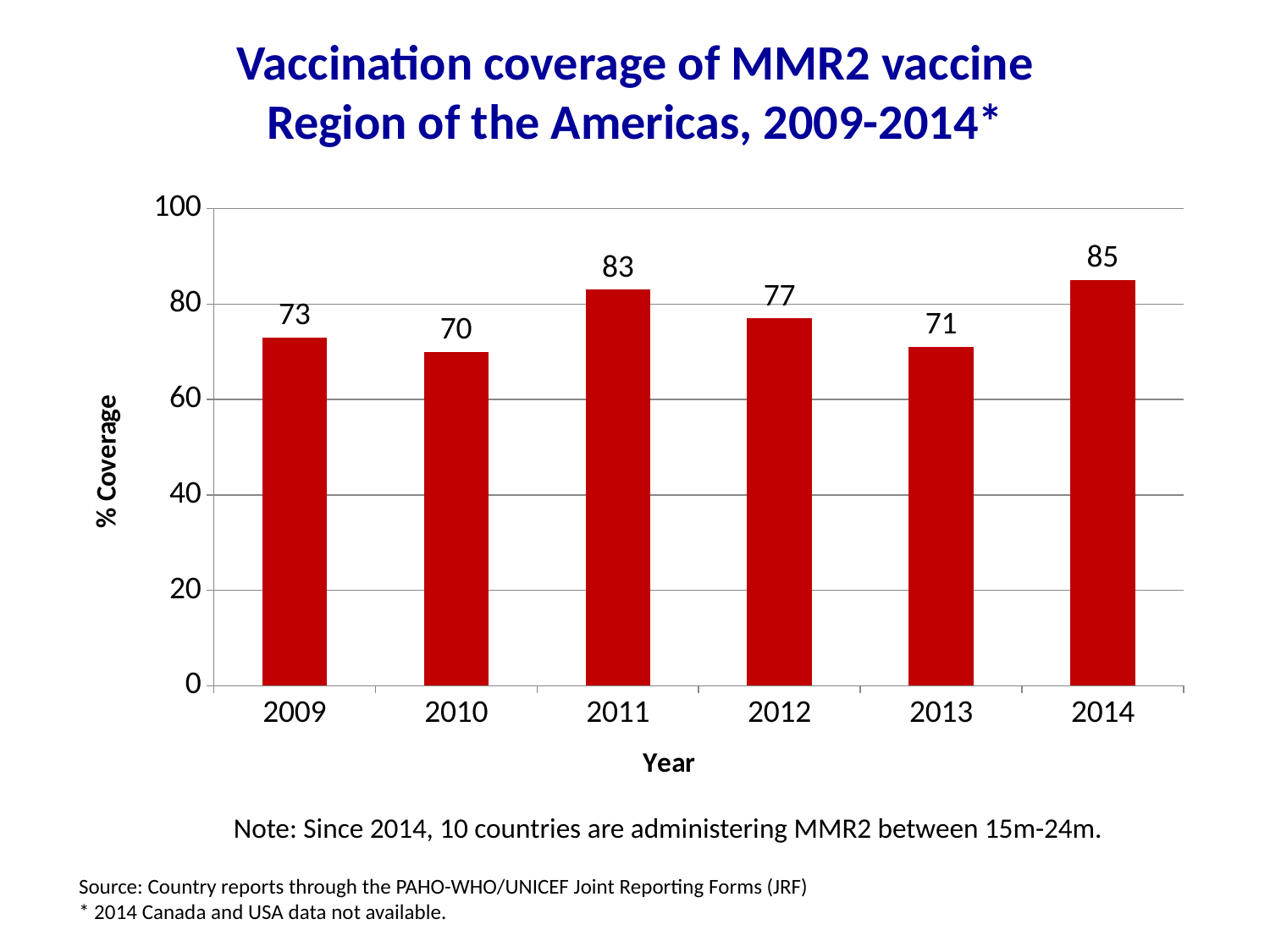
Which year has the lowest % coverage? 2010 Which year has the highest % coverage? 2014 What is the difference in % coverage between 2014 and 2010? 15 What is the difference in % coverage between 2011 and 2012? 6 Which year has higher % coverage, 2012 or 2013? 2012 What is the % coverage for 2011? 83 What is the % coverage for 2013? 71 What is the % coverage for 2009? 73 What is the label of the y axis? % Coverage What kind of chart is shown on the slide? Bar chart Is the value for 2014 greater or less than 80? greater How many years are shown on the x axis? 6